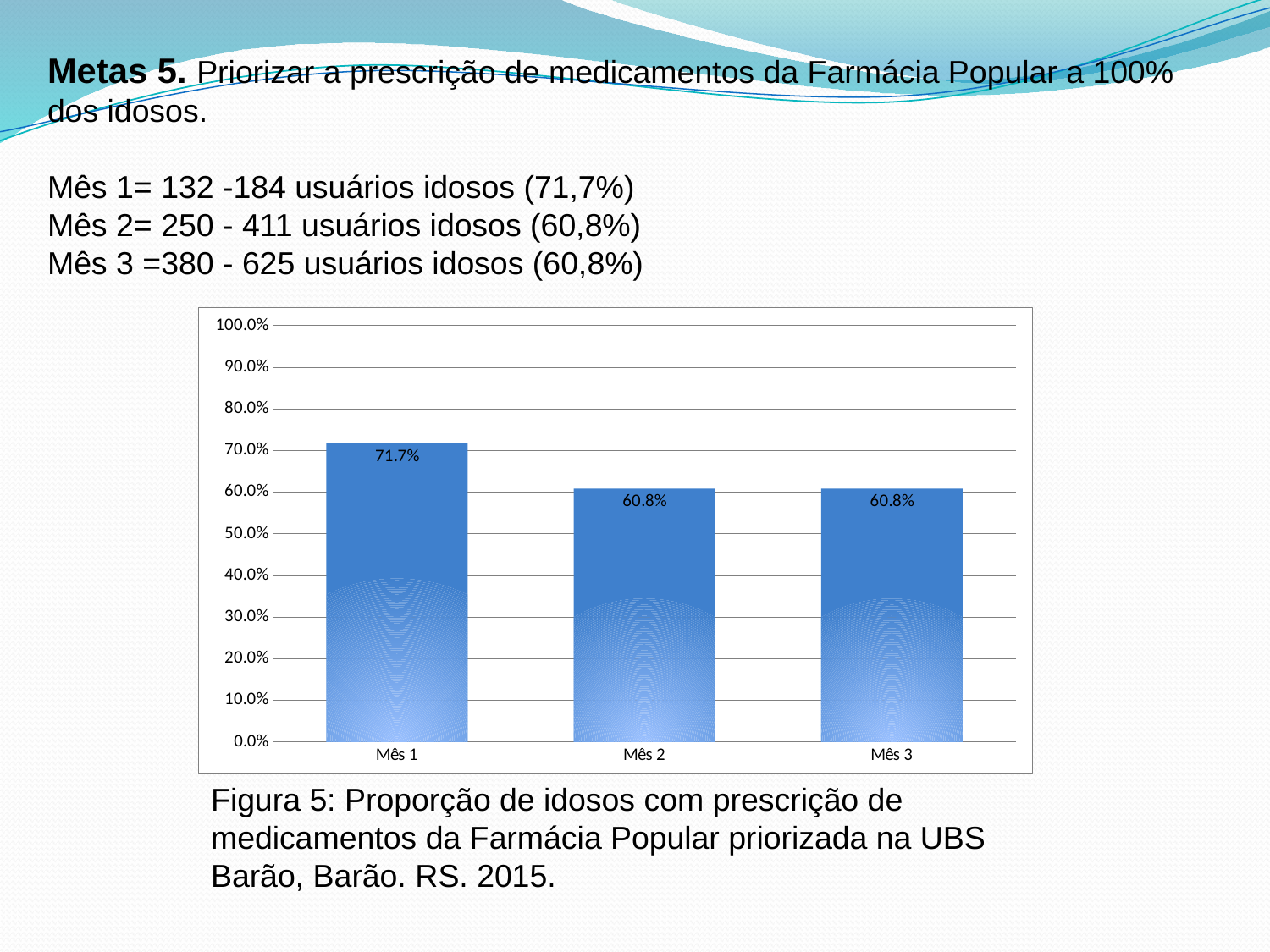
What is the maximum value shown on the y axis? 100.0% What is the value for Mês 2? 60.8% What kind of chart is shown on the slide? bar chart Is the value for Mês 1 greater or less than 70.0%? greater Which is larger, the value for Mês 1 or the value for Mês 3? Mês 1 Do the values rise or fall from Mês 1 to Mês 2? fall Is the value for Mês 2 greater or less than 70.0%? less Which month has the highest value? Mês 1 How many categories are shown on the x axis? 3 What is the difference between the values for Mês 1 and Mês 2? 10.9% What is the value for Mês 3? 60.8% What is the value for Mês 1? 71.7%